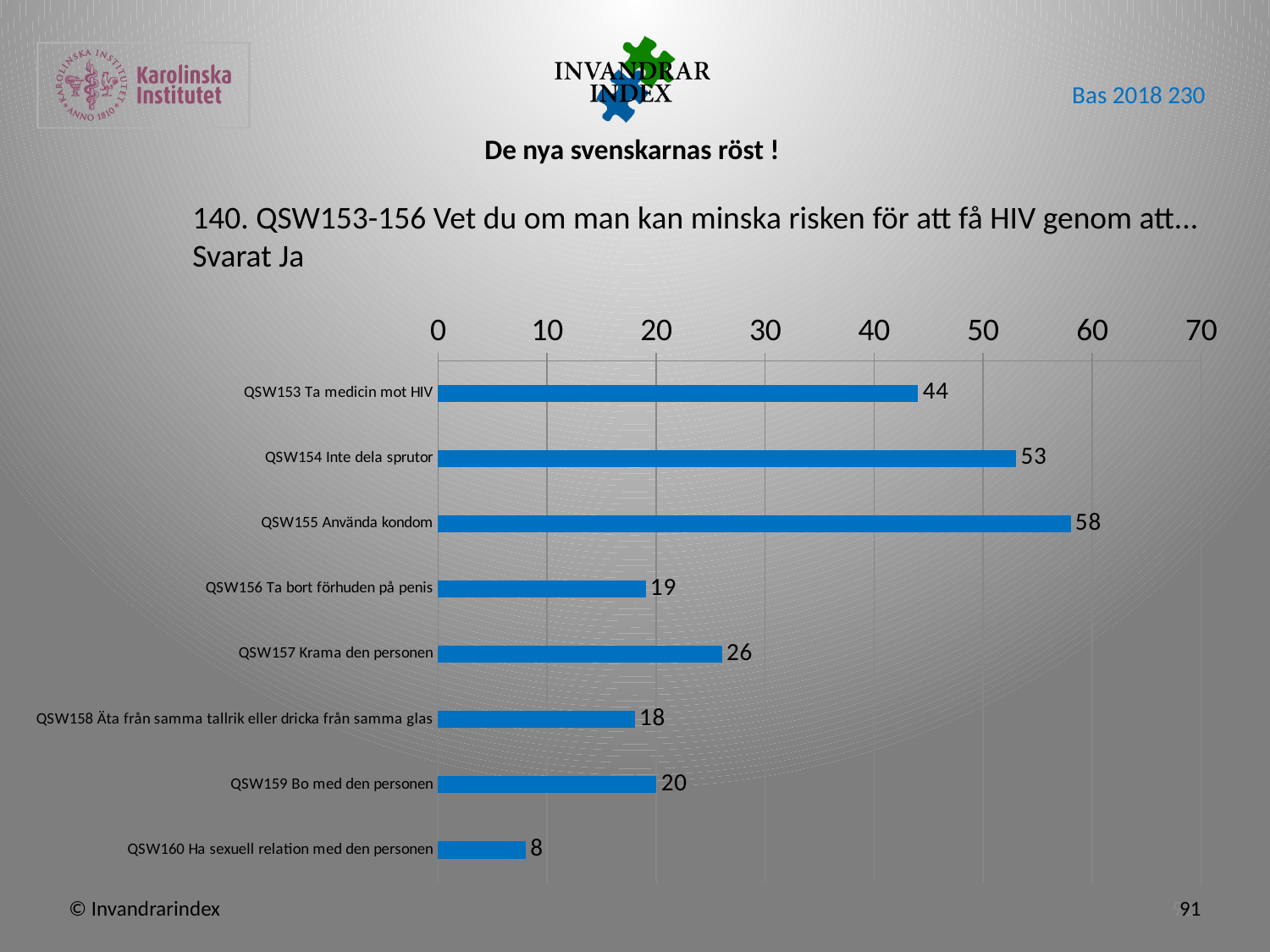
What is the difference between the values for QSW159 Bo med den personen and QSW158 Äta från samma tallrik eller dricka från samma glas? 2 What is the value for QSW153 Ta medicin mot HIV? 44 What is the maximum value shown on the horizontal axis? 70 Which is larger, the value for QSW157 Krama den personen or the value for QSW159 Bo med den personen? QSW157 Krama den personen What is the value for QSW155 Använda kondom? 58 How many categories are shown in the chart? 8 Is the value for QSW156 Ta bort förhuden på penis greater or less than 20? less What kind of chart is shown on the slide? bar chart What is the difference between the values for QSW154 Inte dela sprutor and QSW153 Ta medicin mot HIV? 9 What is the value for QSW160 Ha sexuell relation med den personen? 8 Which category has the highest value? QSW155 Använda kondom Which category has the lowest value? QSW160 Ha sexuell relation med den personen